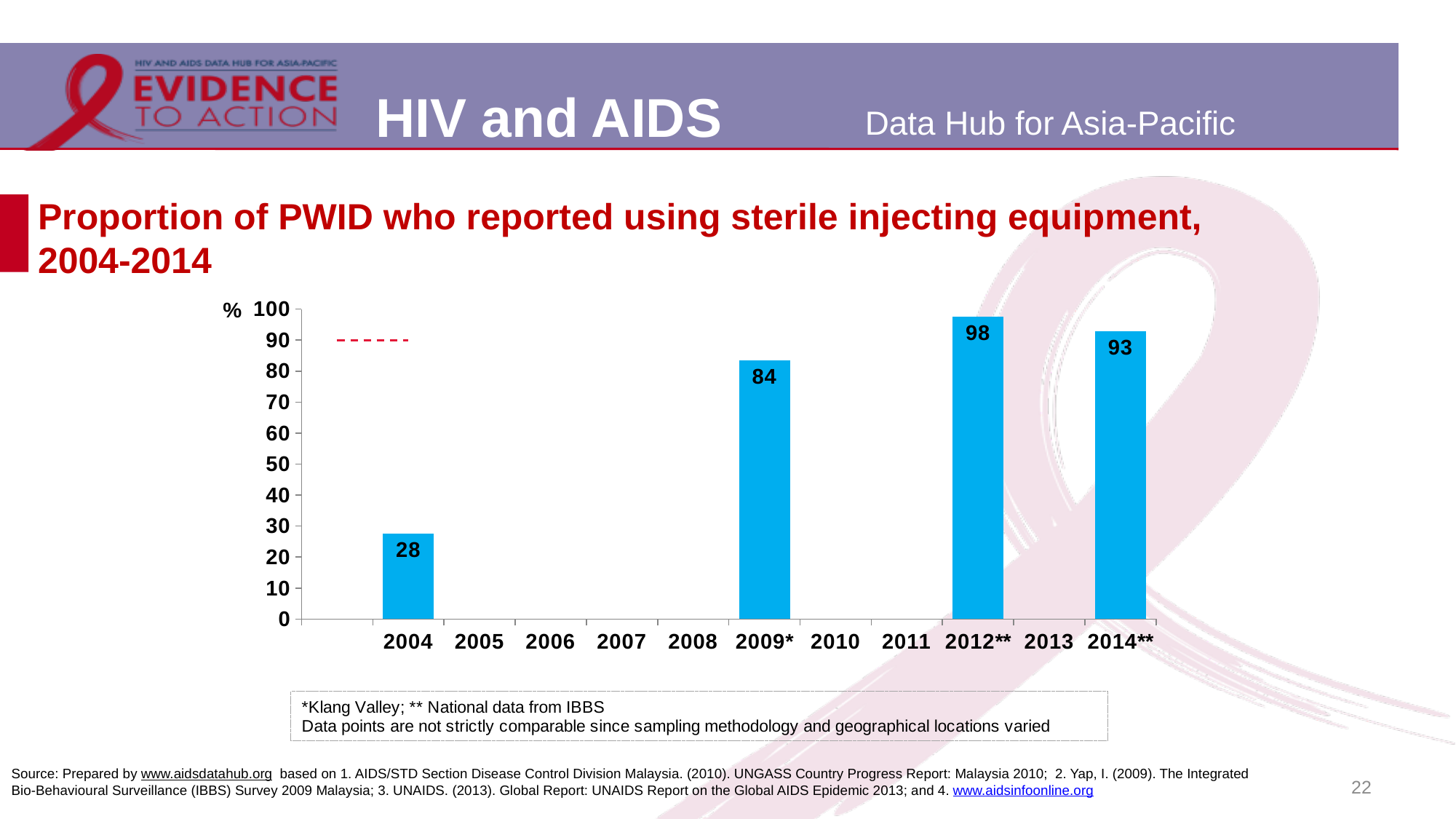
Which year has the highest value? 2012** What is the value for 2004? 28 What is the value for 2009*? 84 What is the difference between the values for 2012** and 2014**? 5 What is the value for 2012**? 98 What is the difference between the values for 2009* and 2004? 56 How many bars are plotted on the chart? 4 What kind of chart is shown on the slide? bar chart What is the title of the chart? Proportion of PWID who reported using sterile injecting equipment, 2004-2014 Which year has the lowest value? 2004 Which is larger, the value for 2009* or the value for 2014**? 2014** What is the value for 2014**? 93